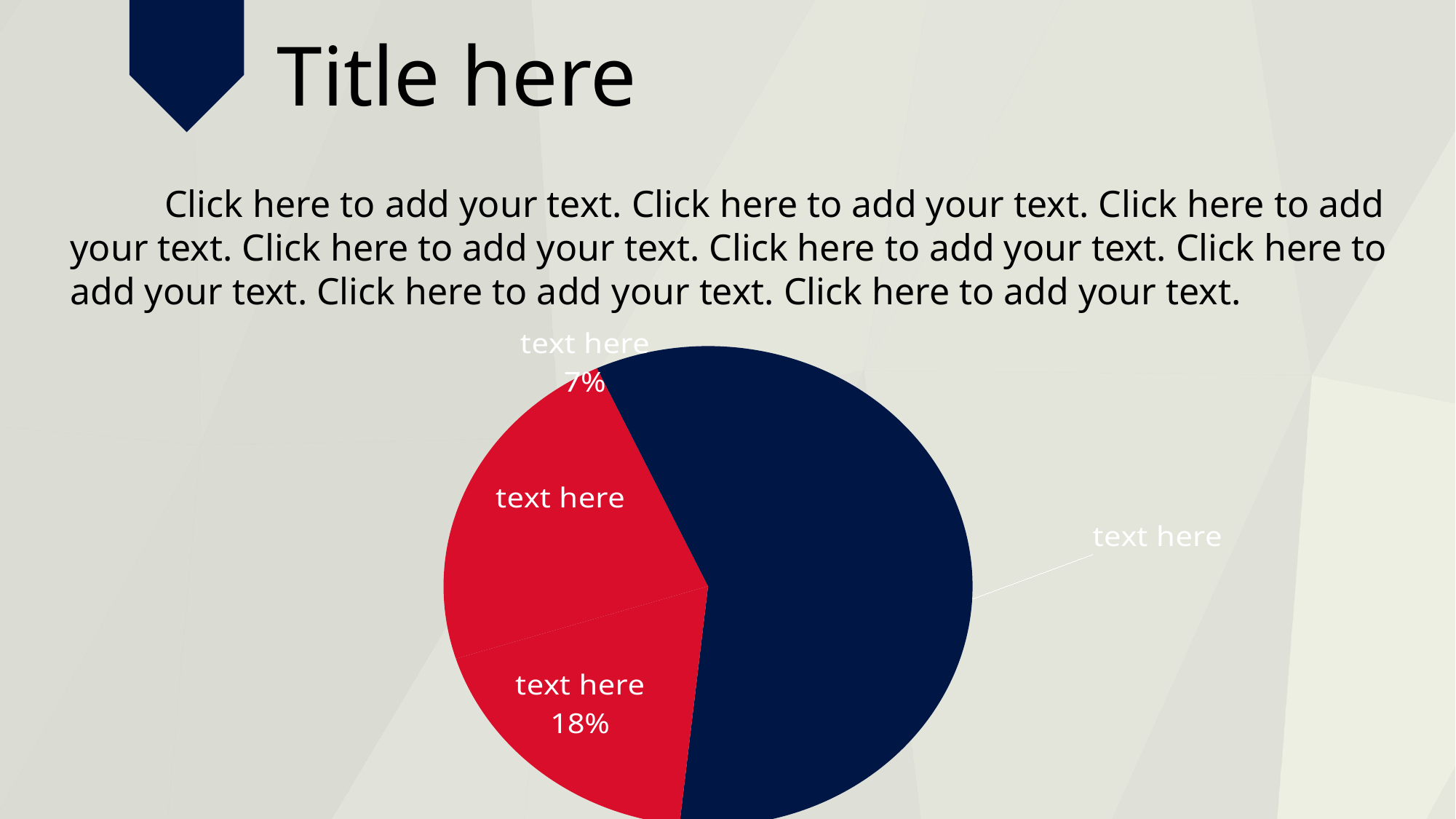
What percentage is printed on the lower red slice of the pie chart? 18% What kind of chart is shown on the slide? pie chart Which is larger, the slice labelled 18% or the slice labelled 7%? the slice labelled 18% Which colour slice is the largest in the pie chart? the dark navy slice What percentage is printed on the small slice at the top of the pie chart? 7% What is the difference between the slice labelled 18% and the slice labelled 7%? 11 percentage points Which two colours are used for the slices of the pie chart? dark navy and red Is the dark navy slice larger or smaller than the slice labelled 18%? larger What label text is used for the slices of the pie chart? text here